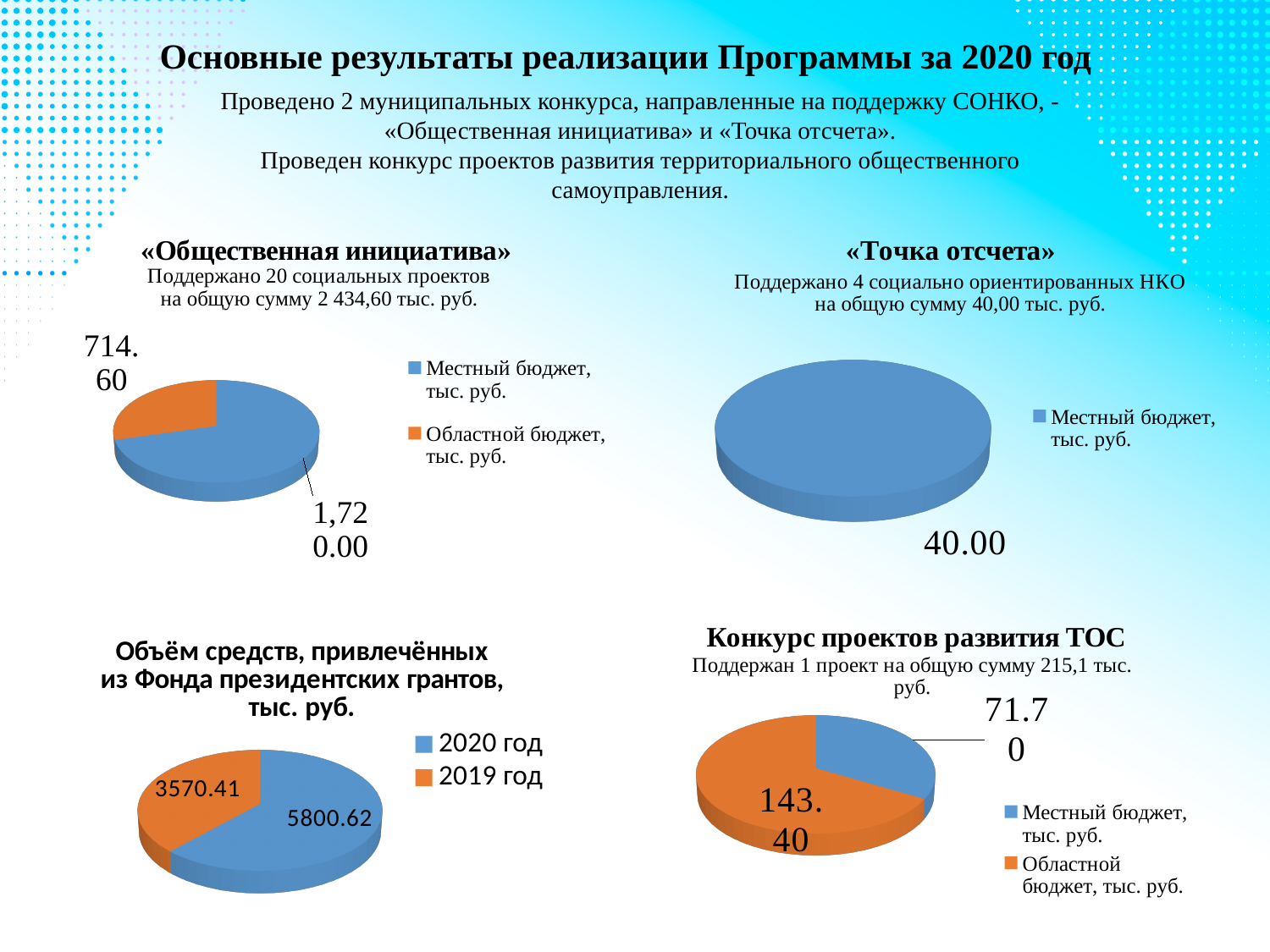
In the «Конкурс проектов развития ТОС» pie chart, which slice is the largest? Областной бюджет, тыс. руб. In the «Общественная инициатива» pie chart, what is the value for Местный бюджет, тыс. руб.? 1,720.00 In the «Конкурс проектов развития ТОС» pie chart, what is the value for Местный бюджет, тыс. руб.? 71.70 In the «Общественная инициатива» pie chart, which slice is larger: Местный бюджет or Областной бюджет? Местный бюджет In the «Общественная инициатива» pie chart, what is the value for Областной бюджет, тыс. руб.? 714.60 In the chart titled «Объём средств, привлечённых из Фонда президентских грантов, тыс. руб.», what is the value for 2020 год? 5800.62 In the «Точка отсчета» pie chart, what value is shown for Местный бюджет, тыс. руб.? 40.00 What type of chart is used for «Объём средств, привлечённых из Фонда президентских грантов, тыс. руб.»? Pie chart In the chart titled «Объём средств, привлечённых из Фонда президентских грантов, тыс. руб.», what is the difference between the 2020 год and 2019 год values? 2230.21 In the «Конкурс проектов развития ТОС» pie chart, what is the value for Областной бюджет, тыс. руб.? 143.40 In the chart titled «Объём средств, привлечённых из Фонда президентских грантов, тыс. руб.», what is the value for 2019 год? 3570.41 How many entries does the legend of the «Точка отсчета» chart list? 1